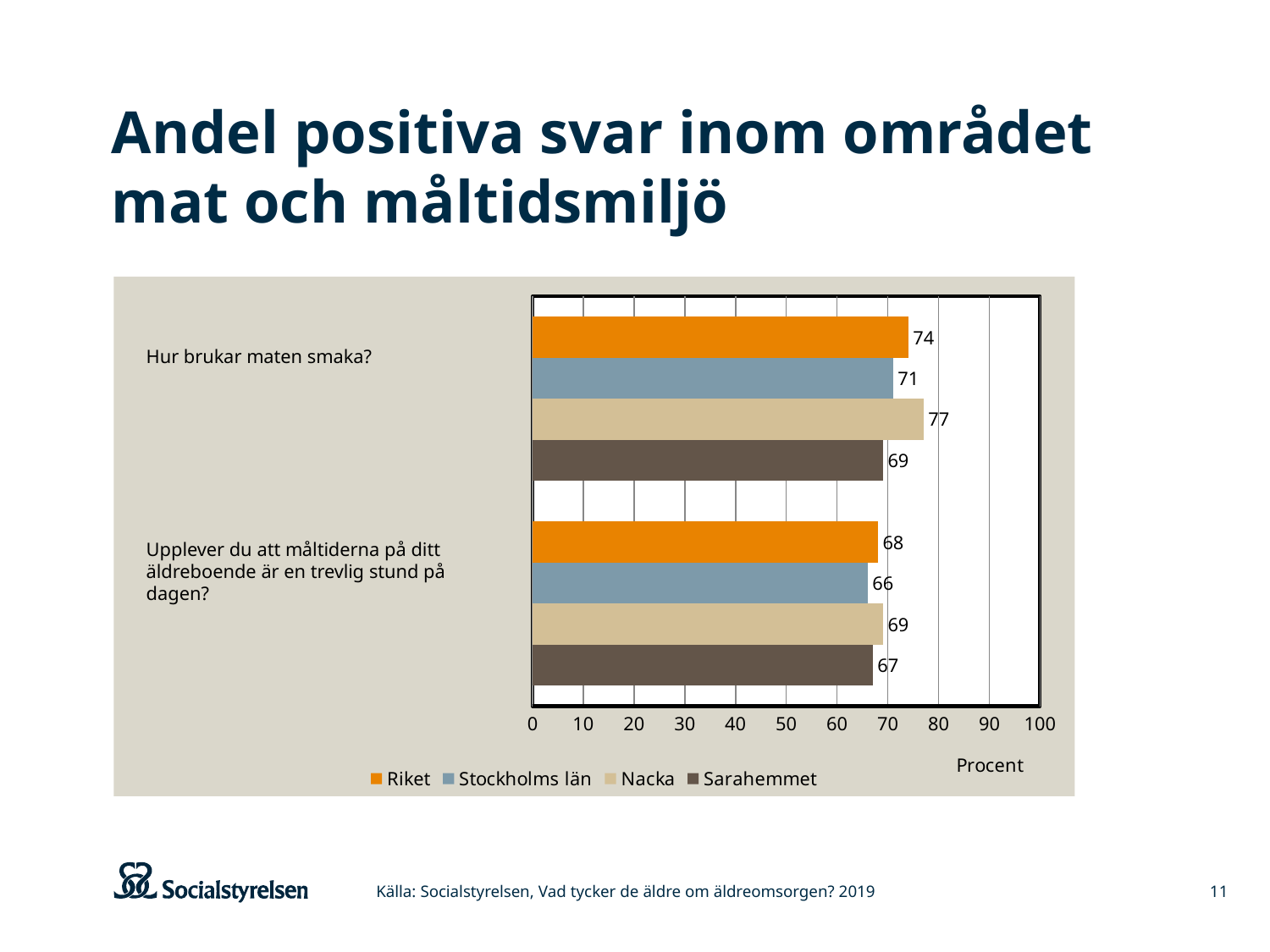
How many questions (categories) are shown on the chart? 2 What is the difference between the Nacka and Sarahemmet values for "Hur brukar maten smaka?"? 8 What is the value for Riket on the question "Hur brukar maten smaka?"? 74 What is the value for Nacka on the question "Hur brukar maten smaka?"? 77 Is the value for Stockholms län on "Hur brukar maten smaka?" greater or less than 60? greater Which is larger for "Upplever du att måltiderna på ditt äldreboende är en trevlig stund på dagen?": Riket or Stockholms län? Riket Which series has the highest value for "Hur brukar maten smaka?"? Nacka Which series has the lowest value for "Upplever du att måltiderna på ditt äldreboende är en trevlig stund på dagen?"? Stockholms län What unit is shown on the x axis of the chart? Procent What is the value for Sarahemmet on the question "Upplever du att måltiderna på ditt äldreboende är en trevlig stund på dagen?"? 67 What kind of chart is shown on the slide? Bar chart How many series does the legend list? 4